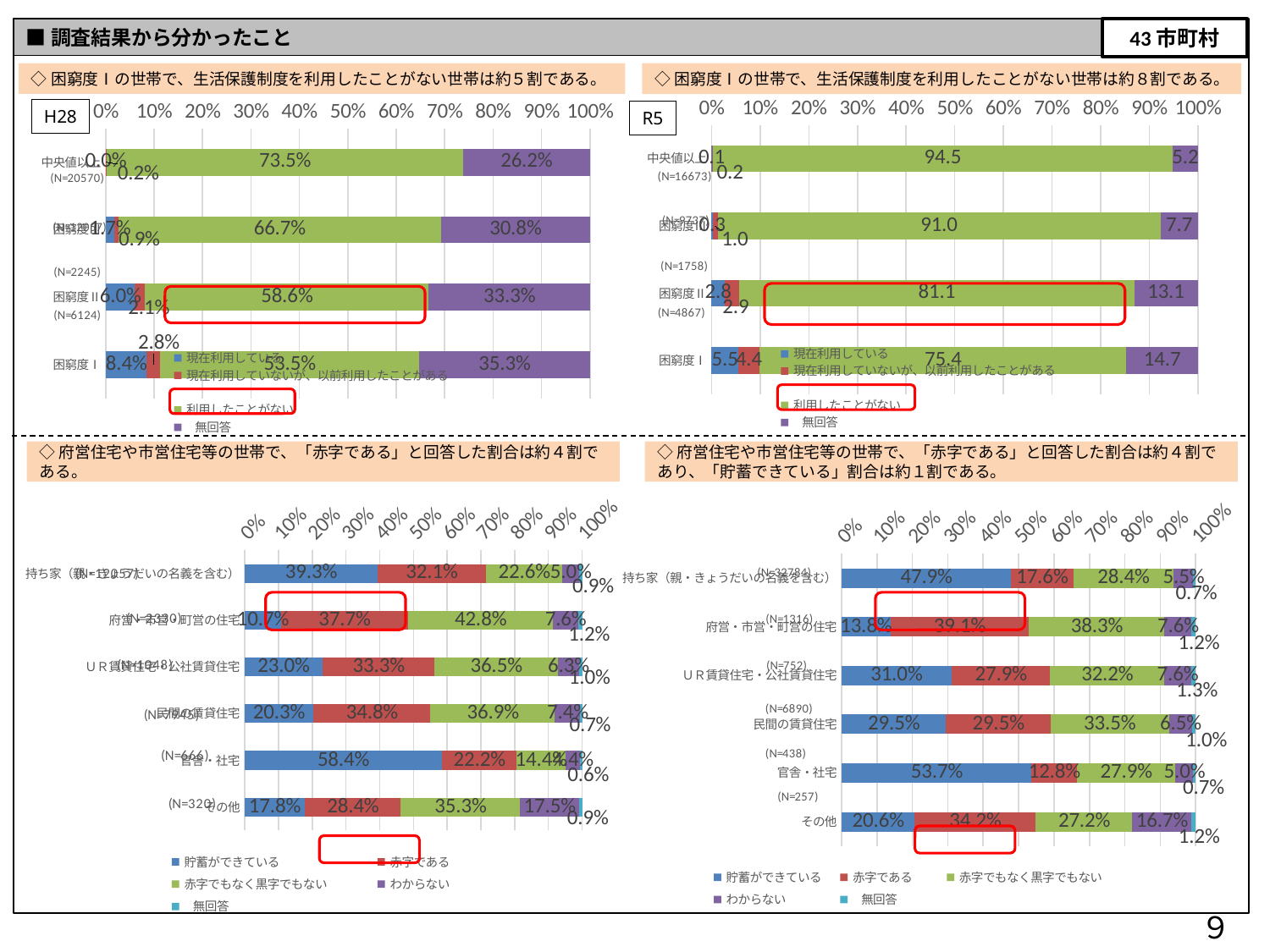
In the bottom-right chart, what is the value of 貯蓄ができている for 府営・市営・町営の住宅? 13.8% In the top-right (R5) chart, how many series does the legend list? 4 What kind of chart is the bottom-left chart? Stacked bar chart In the top-right (R5) chart, which category has the highest value for 利用したことがない? 中央値以上 In the bottom-left chart, what is the value of 赤字である for 府営・市営・町営の住宅? 37.7% In the bottom-right chart, how many series does the legend list? 5 How many categories are shown in the bottom-right chart? 6 In the bottom-right chart, which category has the highest value for 貯蓄ができている? 官舎・社宅 In the bottom-left chart, which is larger for 官舎・社宅: 貯蓄ができている or 赤字である? 貯蓄ができている In the top-left (H28) chart, what is the value of 利用したことがない for 困窮度Ⅰ? 53.5% In the top-left (H28) chart, what is the difference between the 無回答 values for 困窮度Ⅰ and 中央値以上? 9.1% In the top-right (R5) chart, what is the value of 利用したことがない for 困窮度Ⅰ? 75.4